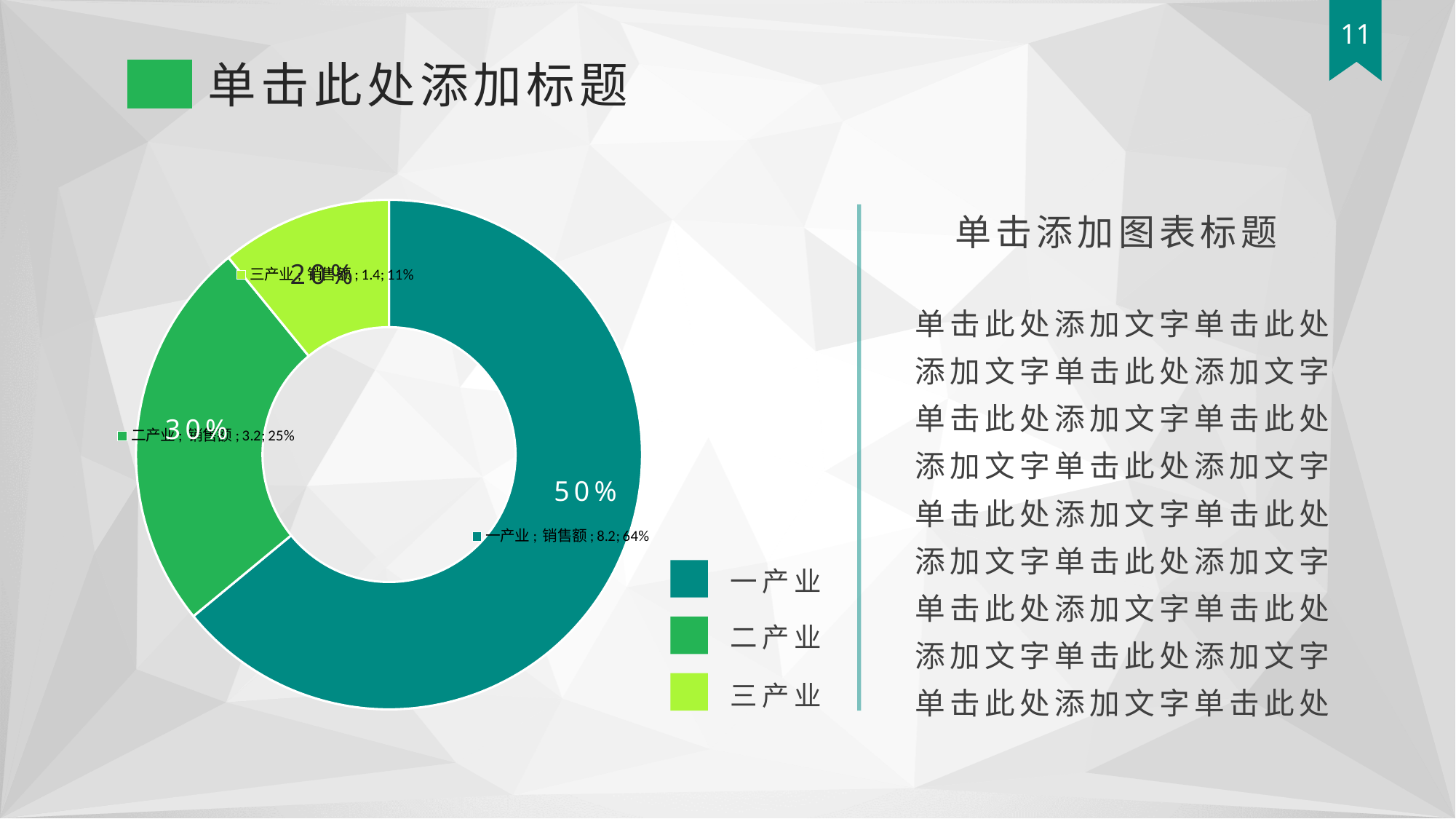
What is the total of the three values shown in the doughnut chart? 12.8 Which category has the smallest slice in the doughnut chart? 三产业 What kind of chart is shown on the slide? doughnut chart What is the difference between the values for 一产业 and 二产业? 5 What is the 销售额 value for 二产业? 3.2 How many categories does the doughnut chart have? 3 How many entries does the chart legend list? 3 What is the 销售额 value for 一产业? 8.2 What is the 销售额 value for 三产业? 1.4 Which is larger, the value for 二产业 or the value for 三产业? 二产业 What is the name of the data series shown in the chart's data labels? 销售额 Which category has the largest slice in the doughnut chart? 一产业